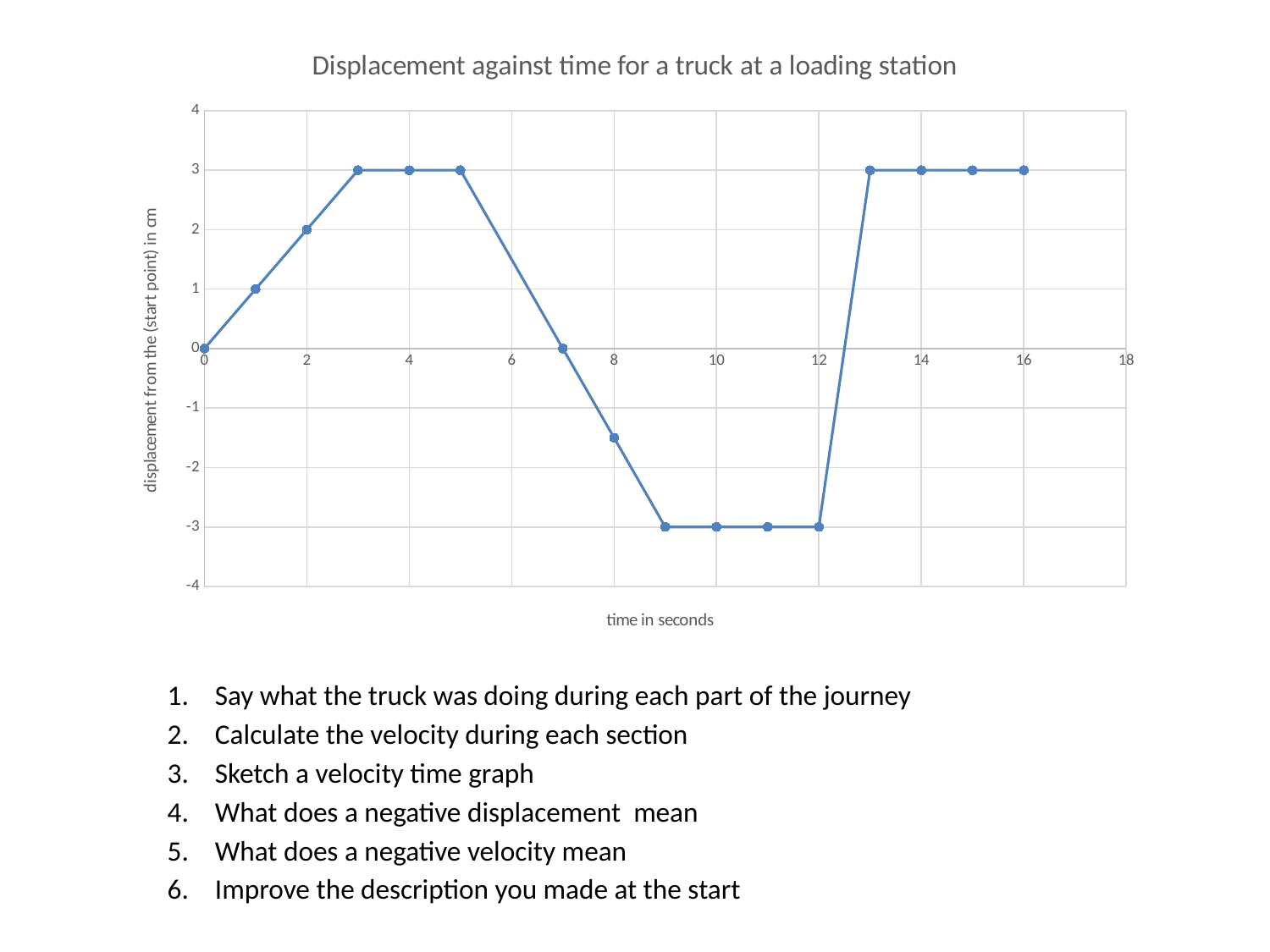
What is the displacement at a time of 7 seconds? 0 Is the displacement at 8 seconds greater or less than -1? less What is the displacement at a time of 10 seconds? -3 How many data points are plotted on the chart? 16 What is the highest displacement value reached on the chart? 3 What is the displacement at a time of 2 seconds? 2 What is the label on the x axis of the chart? time in seconds What kind of chart is shown on the slide? line chart What is the lowest displacement value reached on the chart? -3 Between 5 seconds and 9 seconds, does the displacement rise or fall? fall What is the title of the chart? Displacement against time for a truck at a loading station What is the displacement at a time of 5 seconds? 3